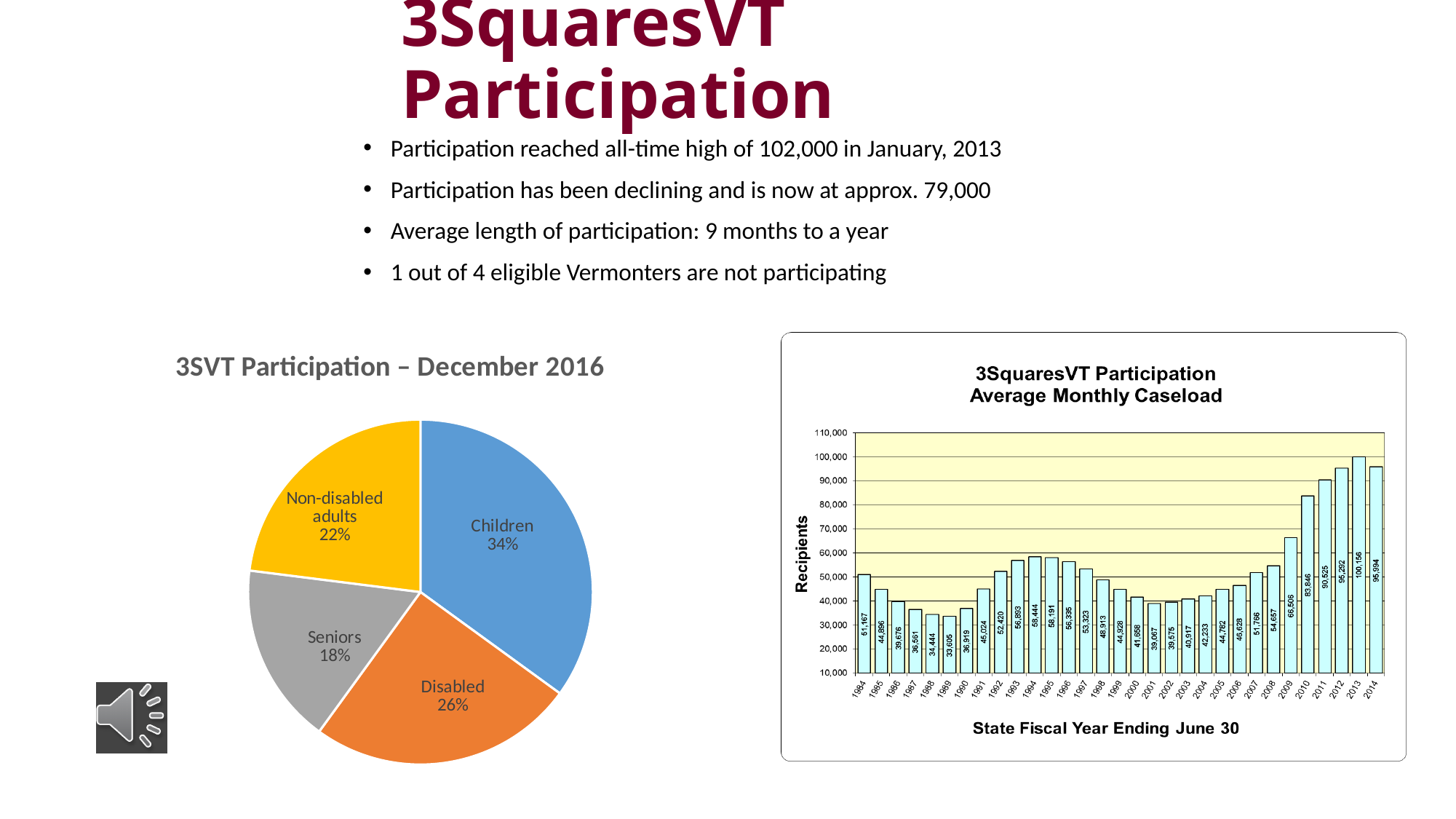
In the chart titled "3SquaresVT Participation Average Monthly Caseload", what is the label on the x axis? State Fiscal Year Ending June 30 In the chart titled "3SquaresVT Participation Average Monthly Caseload", which year had the lowest caseload? 1989 In the chart titled "3SquaresVT Participation Average Monthly Caseload", which year had the highest caseload? 2013 In the pie chart titled "3SVT Participation – December 2016", what is the difference in percentage points between Disabled and Non-disabled adults? 4 In the pie chart titled "3SVT Participation – December 2016", which group has the smallest share? Seniors In the pie chart titled "3SVT Participation – December 2016", which group has the largest share? Children In the chart titled "3SquaresVT Participation Average Monthly Caseload", what was the average monthly caseload in 1984? 51,167 In the chart titled "3SquaresVT Participation Average Monthly Caseload", what was the average monthly caseload in 2013? 100,156 In the chart titled "3SquaresVT Participation Average Monthly Caseload", what kind of chart is used? Bar chart In the pie chart titled "3SVT Participation – December 2016", what share of participants are Seniors? 18% In the pie chart titled "3SVT Participation – December 2016", how many groups are shown? 4 In the pie chart titled "3SVT Participation – December 2016", what share of participants are Children? 34%